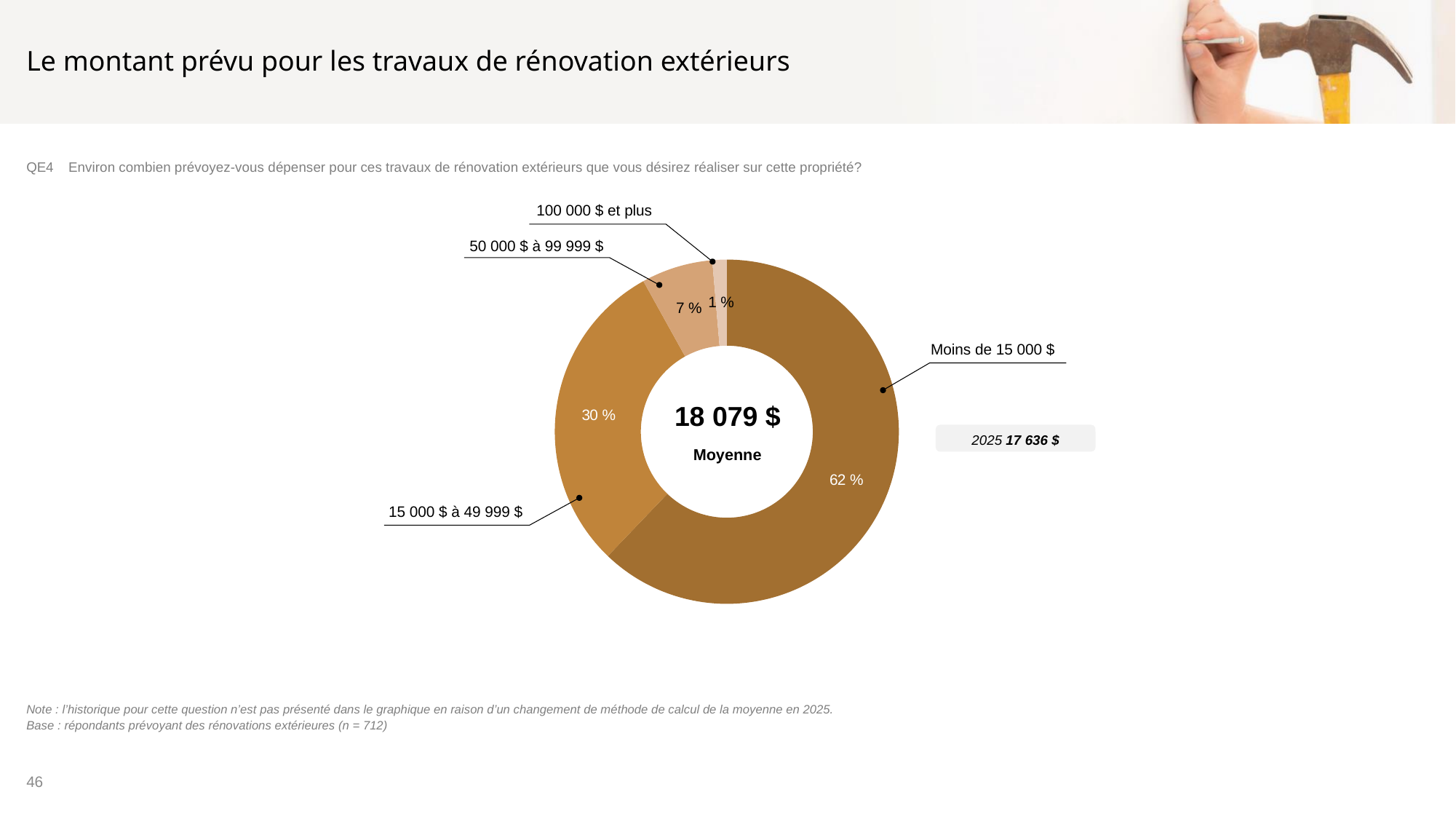
Which category has the largest share of the pie? Moins de 15 000 $ What kind of chart is shown on the slide? Pie chart (donut) What share of respondents plan to spend '50 000 $ à 99 999 $'? 7 % How many categories does the pie chart show? 4 What is the difference in percentage points between 'Moins de 15 000 $' and '15 000 $ à 49 999 $'? 32 points Which is larger: the share for '50 000 $ à 99 999 $' or for '100 000 $ et plus'? 50 000 $ à 99 999 $ What was the average amount shown for 2025? 17 636 $ Which category has the smallest share of the pie? 100 000 $ et plus What share of respondents plan to spend '100 000 $ et plus'? 1 % What share of respondents plan to spend 'Moins de 15 000 $'? 62 % What average amount (Moyenne) is shown in the centre of the chart? 18 079 $ What share of respondents plan to spend '15 000 $ à 49 999 $'? 30 %